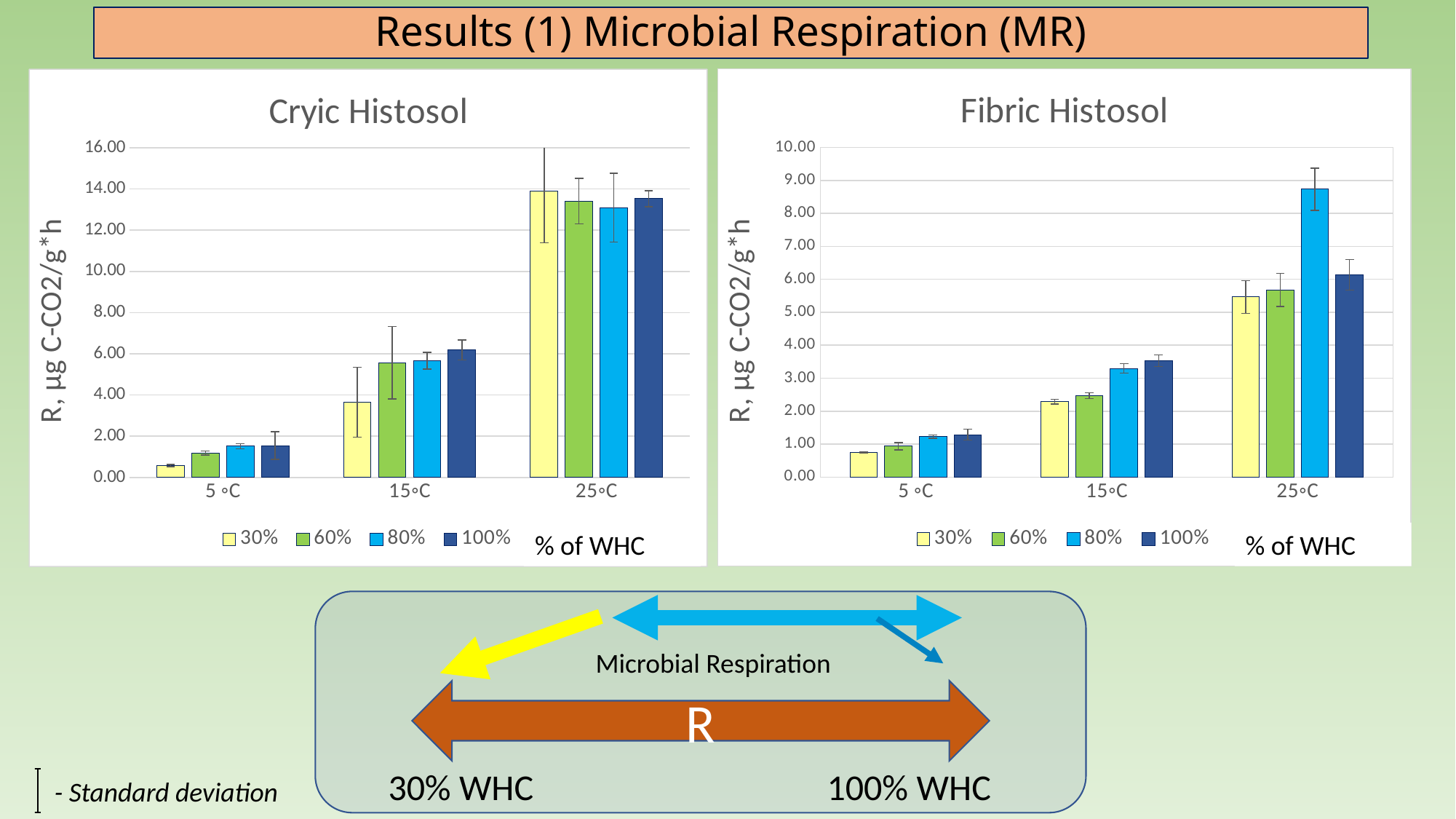
In the Fibric Histosol chart, is the value for 80% at 25°C greater or less than 8.00? greater In the Cryic Histosol chart, which series has the lowest value at 5°C? 30% In the Fibric Histosol chart, is the value for 30% at 5°C greater or less than 1.00? less In the Cryic Histosol chart, is the value for 30% at 15°C greater or less than 4.00? less How many series does the legend of the Fibric Histosol chart list? 4 What kind of chart is the Cryic Histosol chart? bar chart In the Fibric Histosol chart at 15°C, which is larger: the value for 80% or the value for 30%? 80% What is the y-axis label of the Fibric Histosol chart? R, µg C-CO2/g*h In the Cryic Histosol chart, do the values for the 30% series rise or fall as temperature increases from 5°C to 25°C? rise How many temperature categories are shown on the x axis of the Cryic Histosol chart? 3 In the Fibric Histosol chart, which series has the highest value at 25°C? 80%